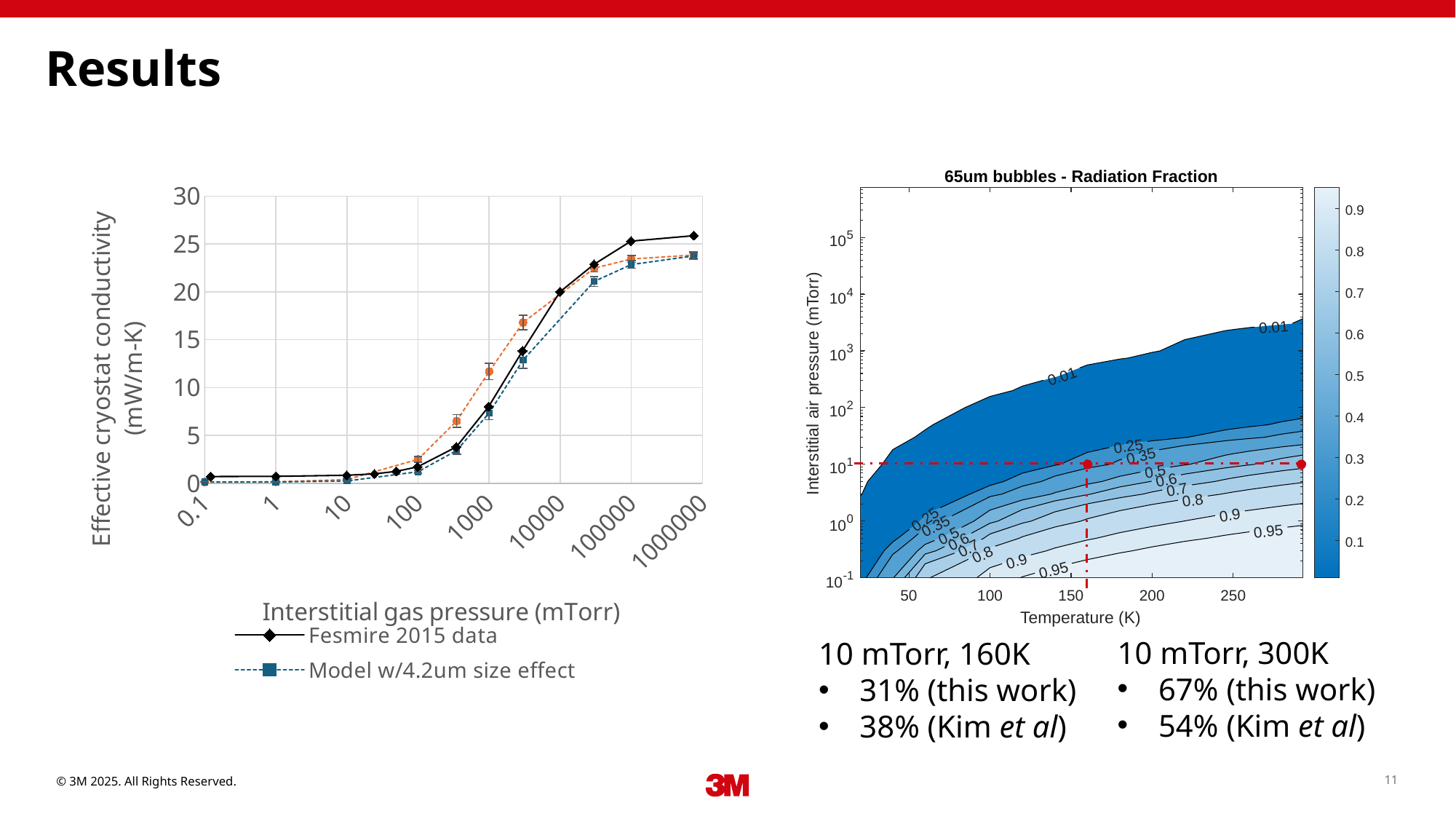
What is the x-axis label of the left chart? Interstitial gas pressure (mTorr) How many series does the legend of the left chart list? 2 What is the highest value shown on the colour bar of the right chart? 0.9 What is the title of the right chart? 65um bubbles - Radiation Fraction In the left chart, is the Fesmire 2015 data value at 1000 mTorr greater or less than 5? greater In the left chart, is the Model w/4.2um size effect value at 1000000 mTorr greater or less than 25? less In the left chart, is the Model w/4.2um size effect value at 10 mTorr greater or less than 5? less In the left chart, do the values of the Fesmire 2015 data series rise or fall as interstitial gas pressure increases? rise What type of chart is the left chart showing effective cryostat conductivity? line chart What is the x-axis label of the right chart? Temperature (K)